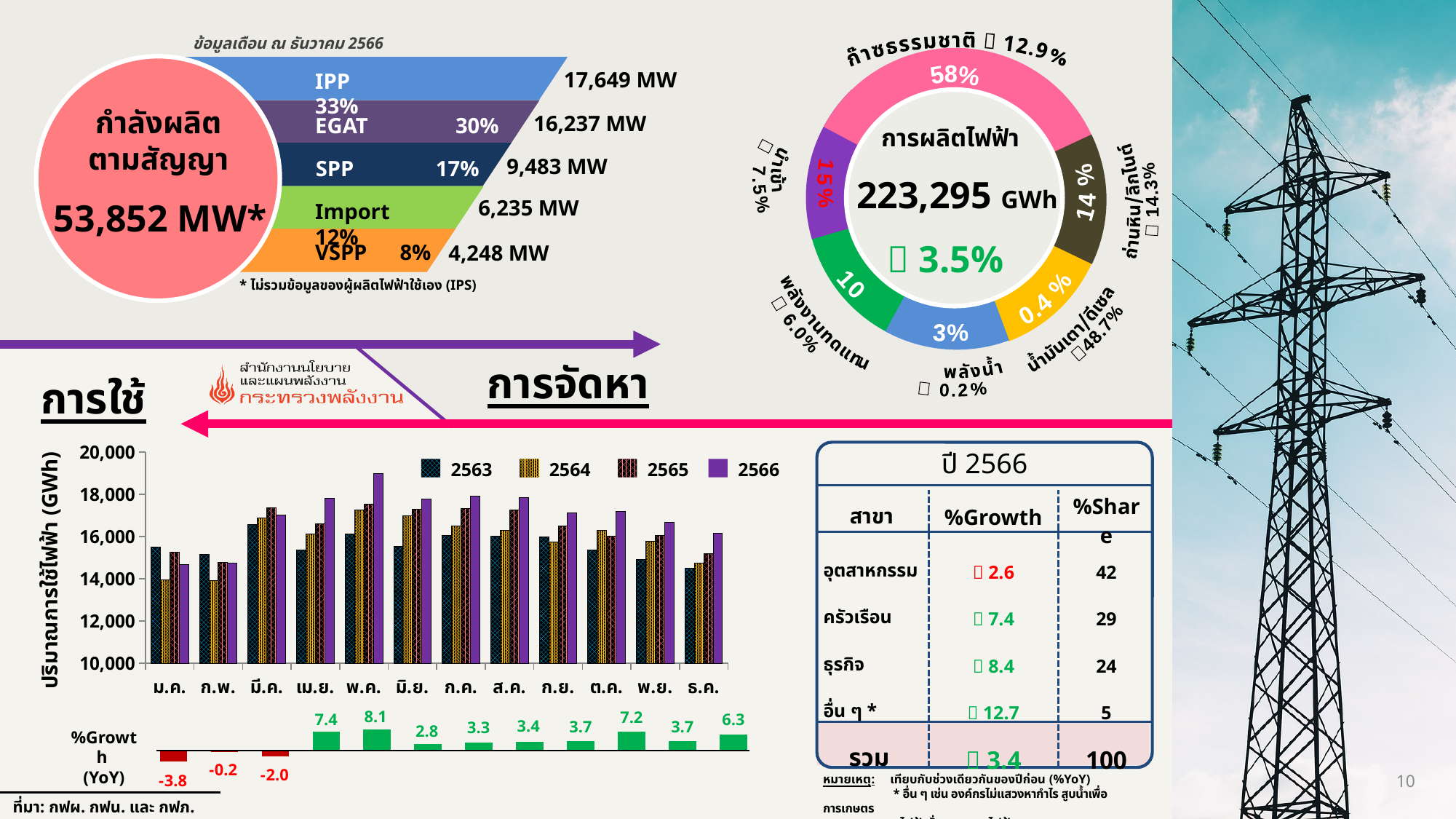
In the %Growth (YoY) chart at the bottom left, which month has the highest growth value? พ.ค. (8.1) In the electricity generation donut chart (การผลิตไฟฟ้า), what share does natural gas (ก๊าซธรรมชาติ) have? 58% In the monthly electricity consumption chart (ปริมาณการใช้ไฟฟ้า), is the 2566 value for พ.ค. greater or less than 18,000? greater In the contracted generating capacity chart (กำลังผลิตตามสัญญา), how much larger is the IPP capacity than the EGAT capacity? 1,412 MW In the %Growth (YoY) chart at the bottom left, what is the growth value for ม.ค.? -3.8 In the contracted generating capacity chart (กำลังผลิตตามสัญญา), which producer type has the smallest capacity? VSPP In the monthly electricity consumption chart (ปริมาณการใช้ไฟฟ้า), in which month is the 2566 value highest? พ.ค. In the contracted generating capacity chart (กำลังผลิตตามสัญญา), what percentage share does EGAT have? 30% In the electricity generation donut chart (การผลิตไฟฟ้า), what total generation is shown in the centre? 223,295 GWh In the contracted generating capacity chart (กำลังผลิตตามสัญญา), what is the capacity for IPP? 17,649 MW In the electricity generation donut chart (การผลิตไฟฟ้า), which fuel source has the smallest share? น้ำมันเตา/ดีเซล (0.4%) In the monthly electricity consumption chart (ปริมาณการใช้ไฟฟ้า), how many series does the legend list? 4